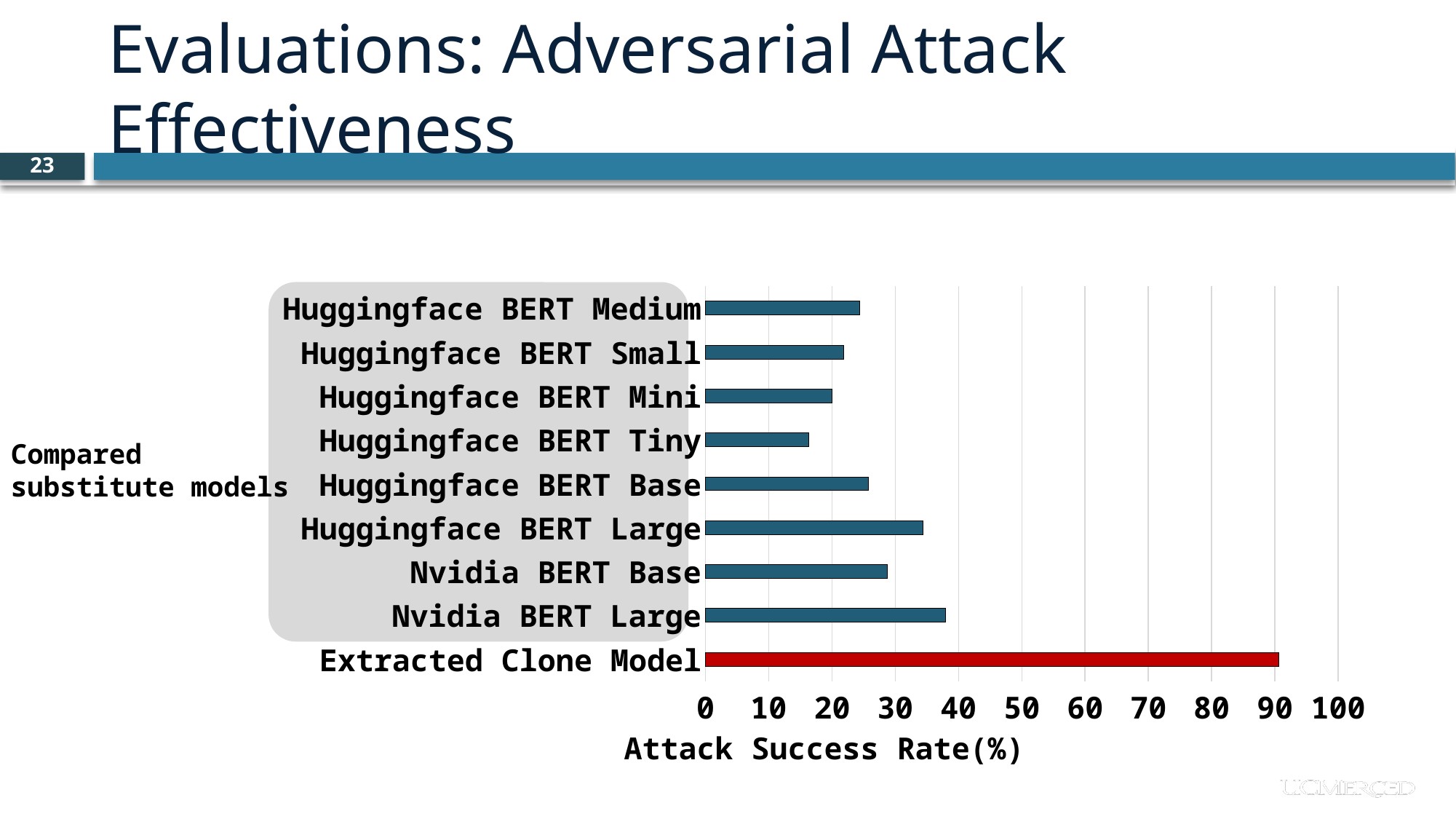
Which model has the highest attack success rate? Extracted Clone Model Is the attack success rate for the Extracted Clone Model greater or less than 80? greater Is the attack success rate for Nvidia BERT Large greater or less than 30? greater What colour is the bar for the Extracted Clone Model? red Is the attack success rate for Huggingface BERT Tiny greater or less than 20? less How many models (categories) are plotted in the chart? 9 Which model has the lowest attack success rate? Huggingface BERT Tiny Which has a higher attack success rate, Nvidia BERT Large or Huggingface BERT Large? Nvidia BERT Large What is the label of the horizontal axis of the chart? Attack Success Rate(%) Which has a higher attack success rate, the Extracted Clone Model or Nvidia BERT Large? Extracted Clone Model What kind of chart is shown on the slide? bar chart